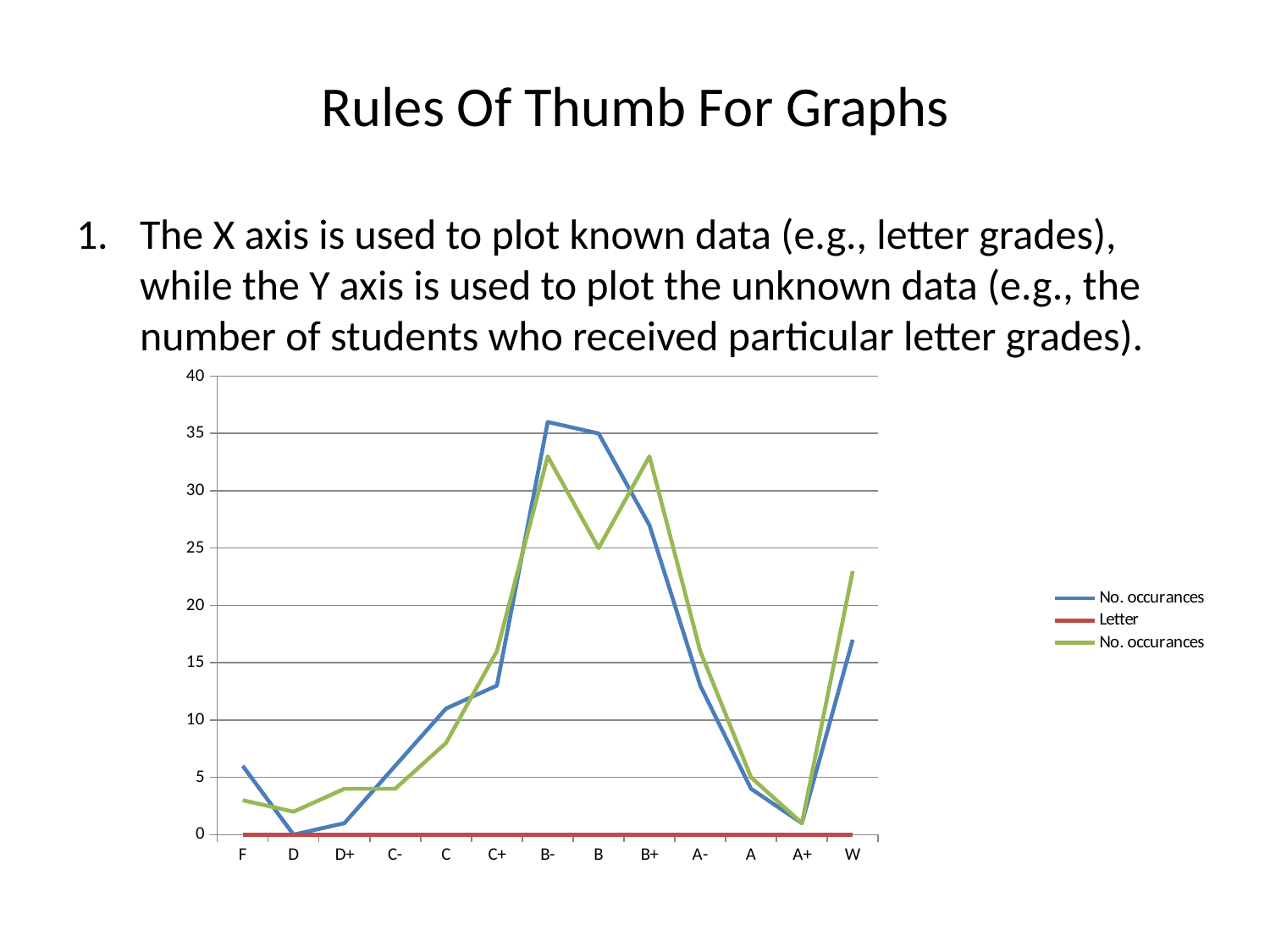
At which letter grade does the blue 'No. occurances' line reach its highest value? B- Is the value of the blue 'No. occurances' line at B- greater or less than 30? greater What colour is the 'Letter' series in the chart's legend? red How many series does the chart's legend list? 3 What kind of chart is shown on the slide? line chart Is the value of the green 'No. occurances' line at C greater or less than 10? less Is the value of the green 'No. occurances' line at W greater or less than 20? greater At grade B, which line is higher: the blue 'No. occurances' line or the green 'No. occurances' line? the blue line How many categories are shown along the x axis of the chart? 13 Does the blue 'No. occurances' line rise or fall from B- to A+? fall At grade W, which line is higher: the blue 'No. occurances' line or the green 'No. occurances' line? the green line